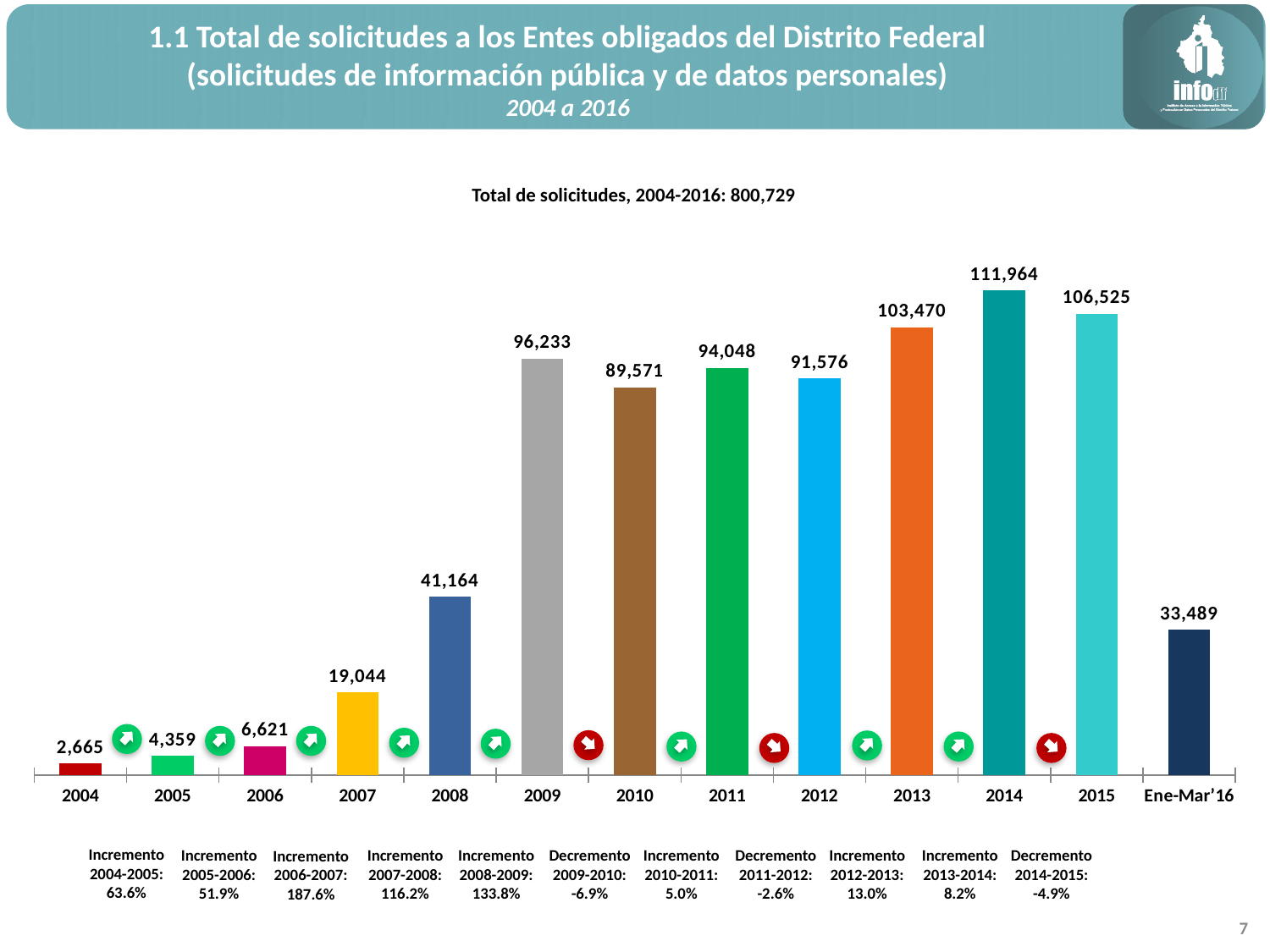
What is the difference between the values for 2009 and 2010? 6,662 What is the difference between the values for 2014 and 2015? 5,439 Which category has the lowest value? 2004 What total of solicitudes for 2004-2016 is stated above the chart? 800,729 Which year has the highest number of solicitudes? 2014 How many categories are shown on the x axis? 13 Do the values rise or fall from 2004 to 2009? Rise What kind of chart is shown on the slide? Bar chart What is the value for 2014? 111,964 What is the value for 2007? 19,044 Which is larger, the value for 2011 or the value for 2012? 2011 What is the value for Ene-Mar'16? 33,489